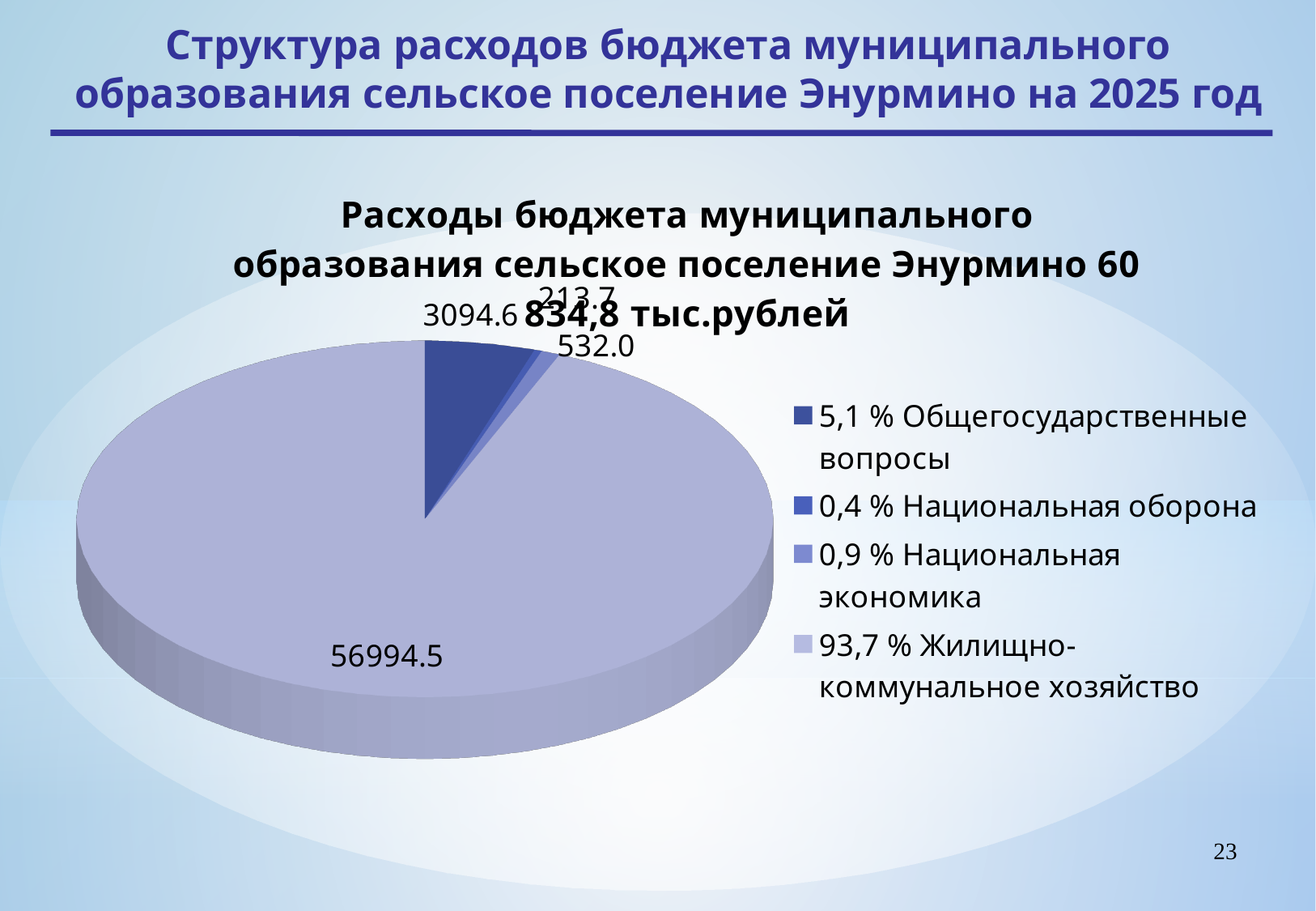
How many slices does the pie chart have? 4 What kind of chart is shown on the slide? pie chart Which category has the largest slice of the pie? Жилищно-коммунальное хозяйство What is the difference between the values for Общегосударственные вопросы and Национальная экономика? 2562.6 What is the value shown for Жилищно-коммунальное хозяйство? 56994.5 What share of the pie does Общегосударственные вопросы represent, according to the legend? 5,1 % What is the value shown for Общегосударственные вопросы? 3094.6 What is the value shown for Национальная экономика? 532.0 Which is larger: the value for Общегосударственные вопросы or the value for Национальная экономика? Общегосударственные вопросы Which category has the smallest slice of the pie? Национальная оборона What share of the pie does Жилищно-коммунальное хозяйство represent, according to the legend? 93,7 % How many entries does the legend list? 4